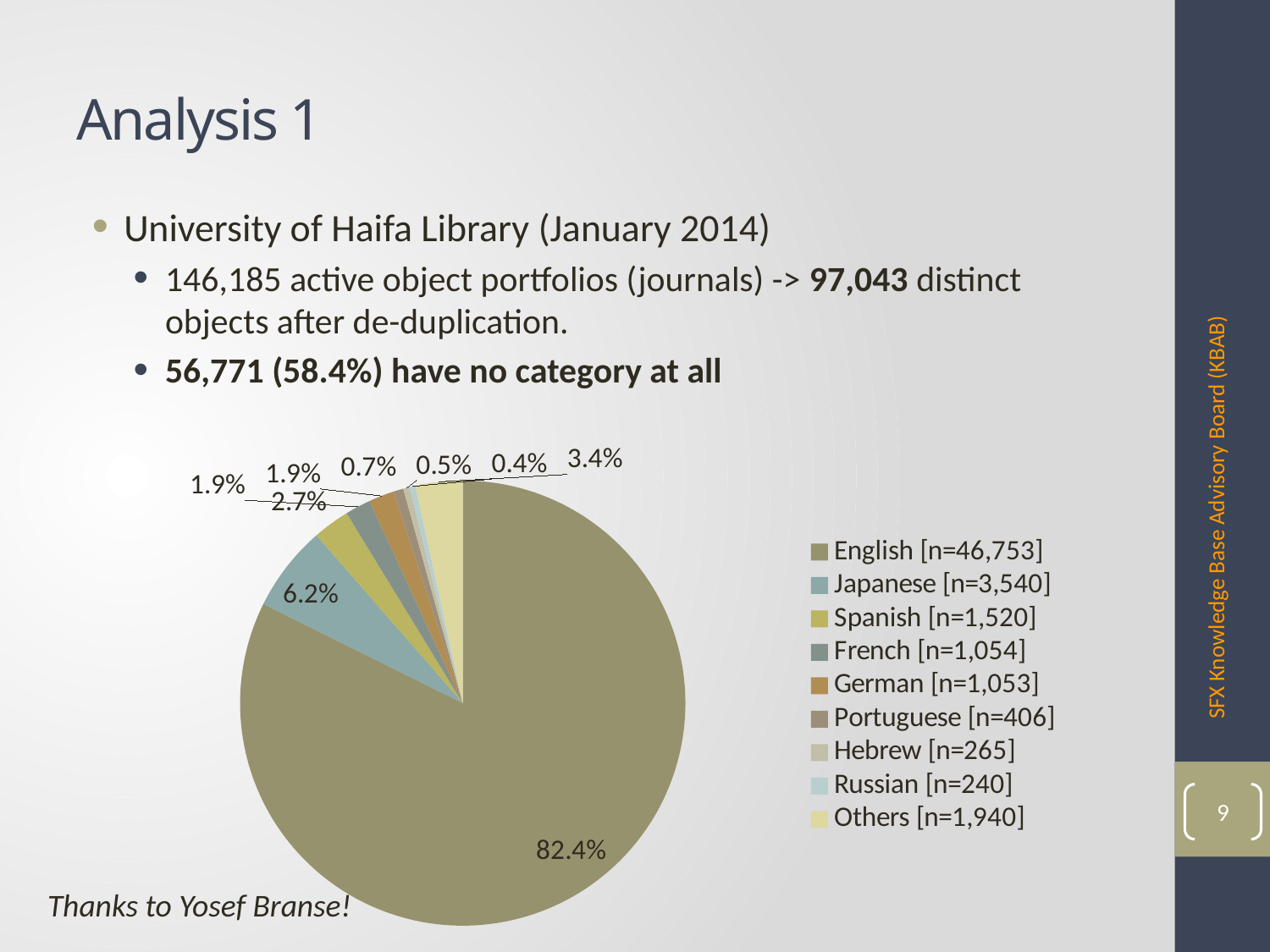
Which category has the smallest n value in the legend? Russian What is the difference between the n values for Japanese and Spanish? 2,020 According to the legend, what is the n value for Spanish? 1,520 Which has a larger n value, French or Portuguese? French What share of the pie does Japanese account for? 6.2% What share of the pie does Others account for? 3.4% Which legend entry is shown in the lightest yellow colour? Others [n=1,940] How many categories does the pie chart's legend list? 9 What type of chart is shown on the slide? pie chart What share of the pie does English account for? 82.4% According to the legend, what is the n value for Hebrew? 265 Which category has the largest slice of the pie? English